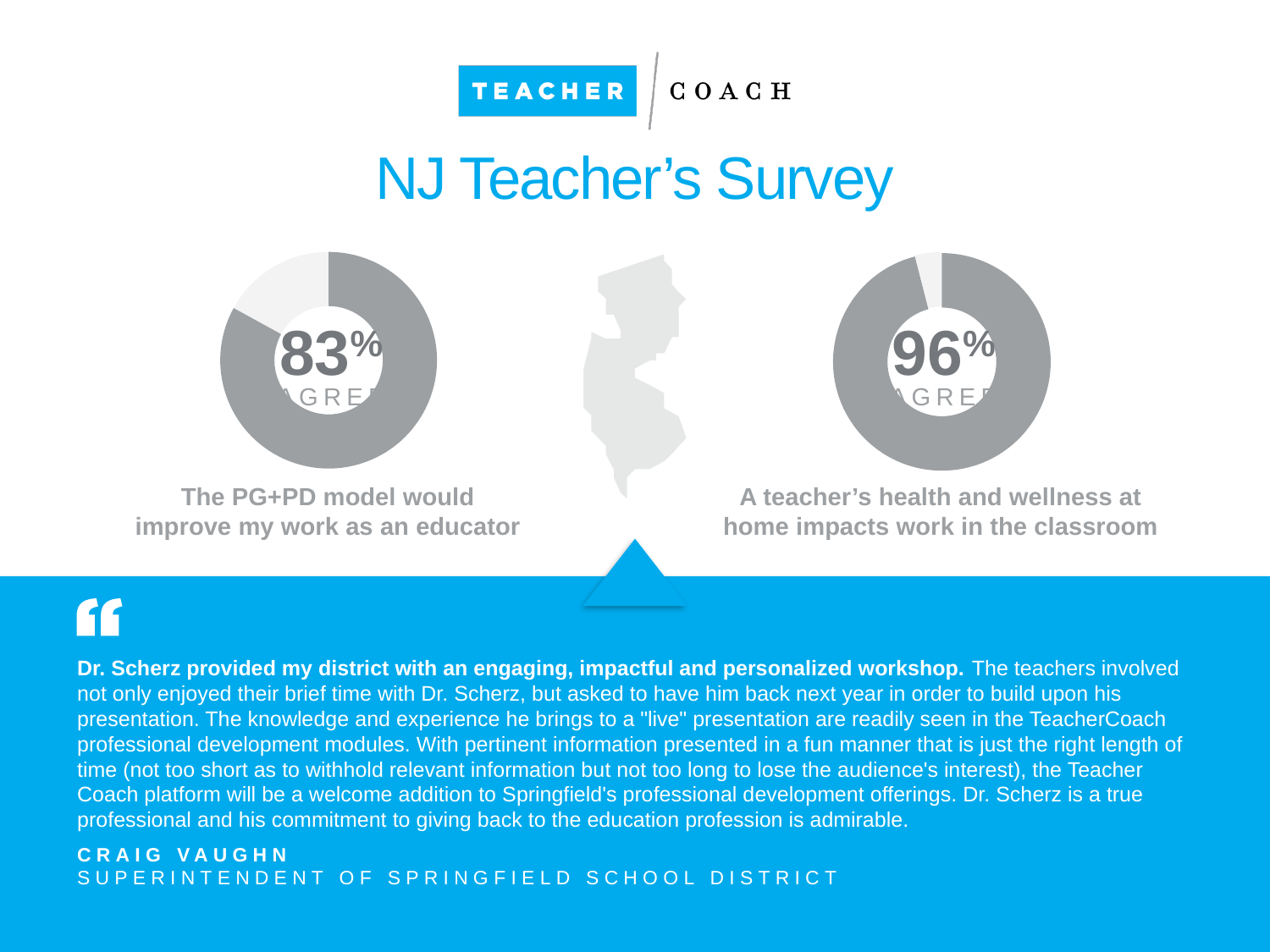
What kind of chart is used to show the survey results on this slide? Donut (pie) chart Which of the two survey statements has the lower agreement percentage? The PG+PD model would improve my work as an educator What word appears beneath the percentage inside each donut chart? AGREE In the right donut chart, what percentage of teachers agree that a teacher's health and wellness at home impacts work in the classroom? 96% Is the agreement percentage for the PG+PD model statement greater or less than 80%? greater What is the title of the slide containing the two donut charts? NJ Teacher's Survey In the left donut chart, what share of the ring is not shaded dark grey (i.e., the portion not agreeing)? 17% What is the difference in percentage points between the agreement for the health and wellness statement and the PG+PD model statement? 13 In the right donut chart, what share of the ring is not shaded dark grey (i.e., the portion not agreeing)? 4% Which statement received the higher agreement percentage: the PG+PD model improving work as an educator, or health and wellness at home impacting classroom work? A teacher's health and wellness at home impacts work in the classroom How many donut charts are shown on the slide? 2 In the left donut chart, what percentage of teachers agree that the PG+PD model would improve their work as an educator? 83%